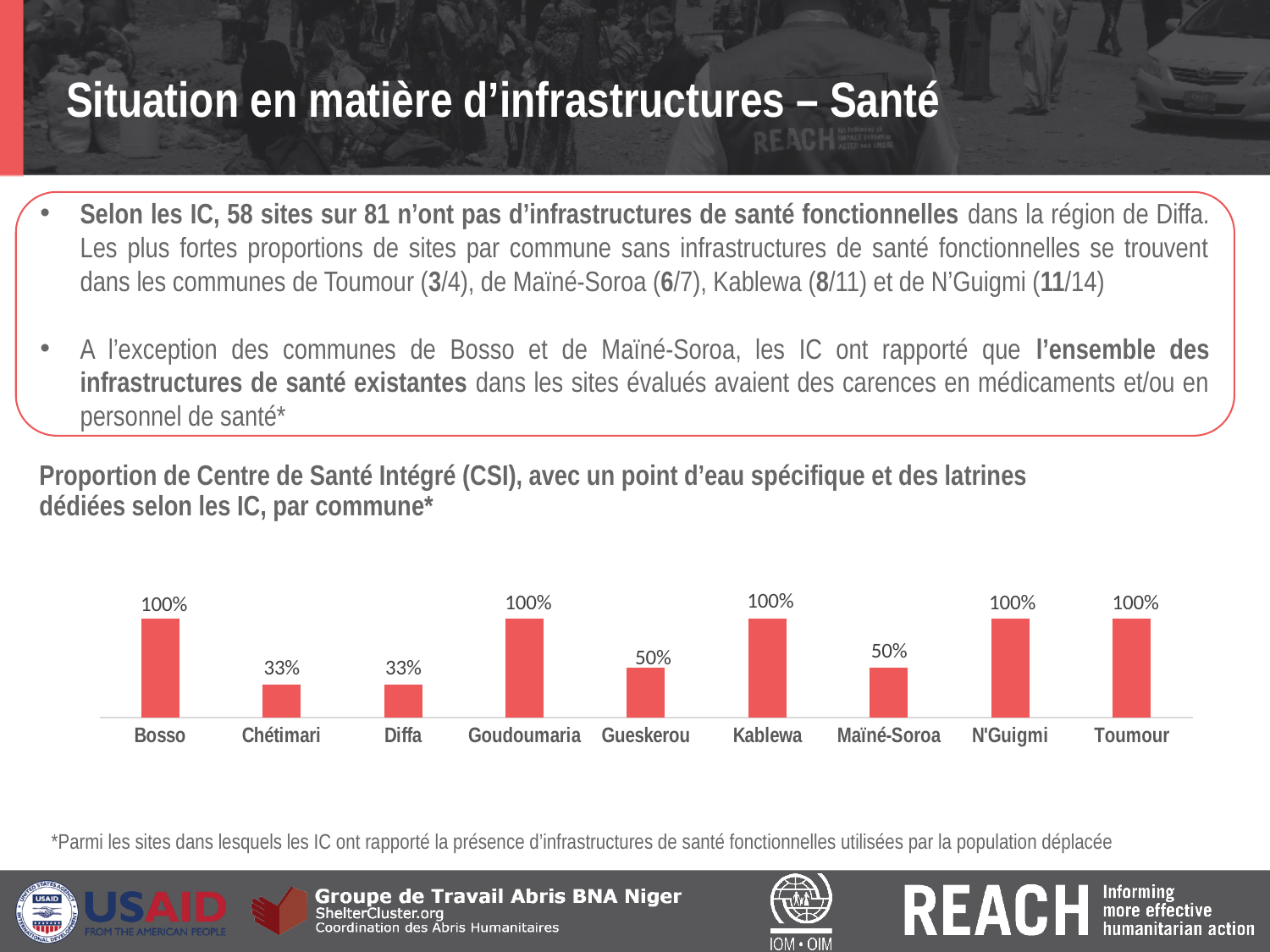
Which is larger, the value for Maïné-Soroa or the value for N'Guigmi? N'Guigmi Which communes have the lowest value in the chart? Chétimari and Diffa How many communes are shown in the chart? 9 What is the value for Chétimari? 33% What is the value for Maïné-Soroa? 50% What is the difference between the values for Bosso and Diffa? 67% Which is larger, the value for Chétimari or the value for Gueskerou? Gueskerou What is the value for Gueskerou? 50% How many communes have a value of 100%? 5 What is the value for Kablewa? 100% What is the difference between the values for Goudoumaria and Gueskerou? 50% What kind of chart is shown on the slide? Bar chart